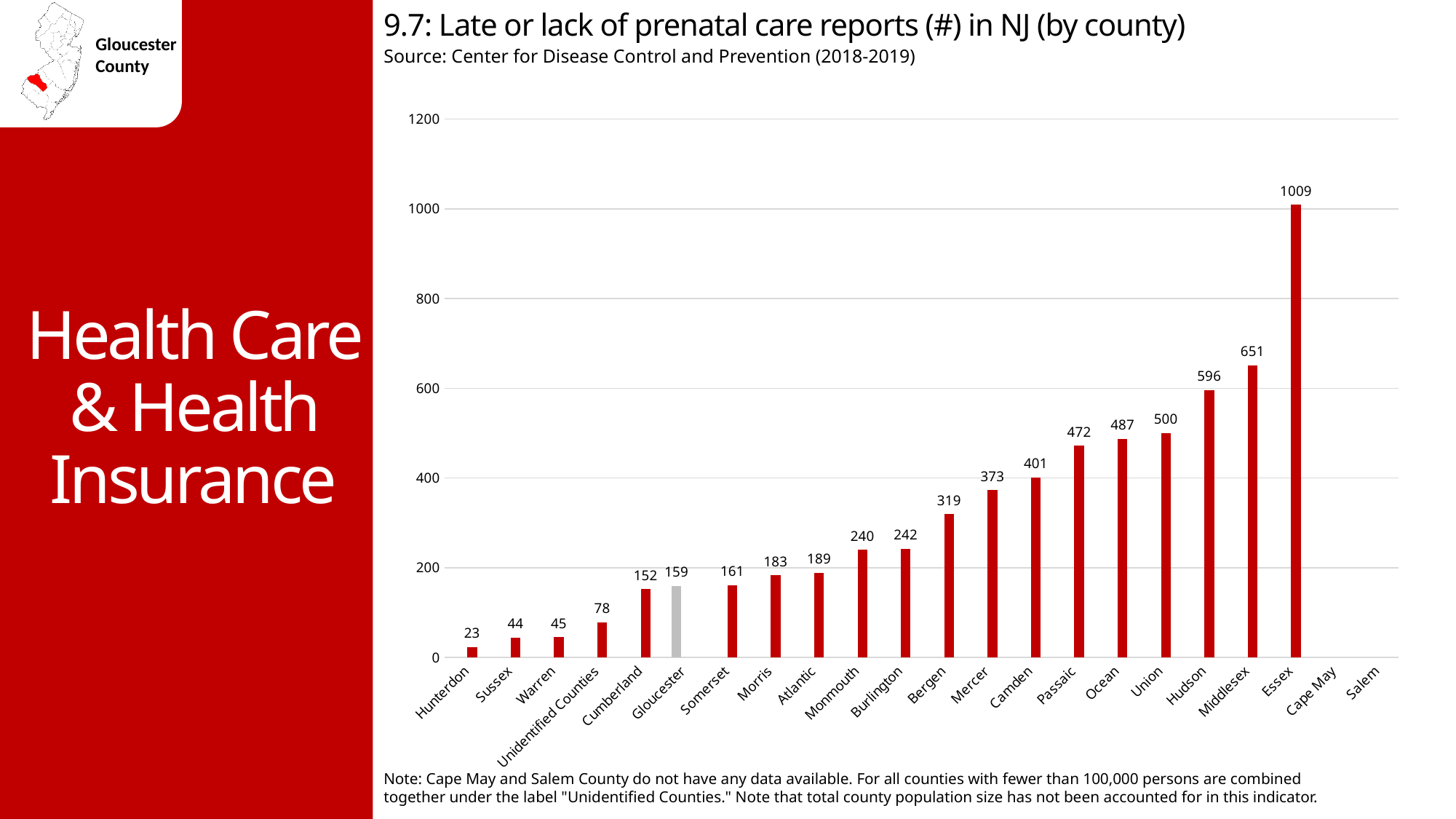
Which bar is coloured grey instead of red? Gloucester What is the difference between the values for Middlesex and Hudson? 55 What is the value for Essex? 1009 What kind of chart is shown on the slide? Bar chart Which county has the highest number of late or lack of prenatal care reports? Essex Among the counties with data shown, which has the lowest value? Hunterdon Is the value for Passaic greater or less than 400? greater How many categories are shown on the x axis? 22 What is the value for Unidentified Counties? 78 Do the values generally rise or fall from Hunterdon to Essex along the x axis? Rise What is the value for Gloucester? 159 Which is larger, the value for Camden or the value for Mercer? Camden